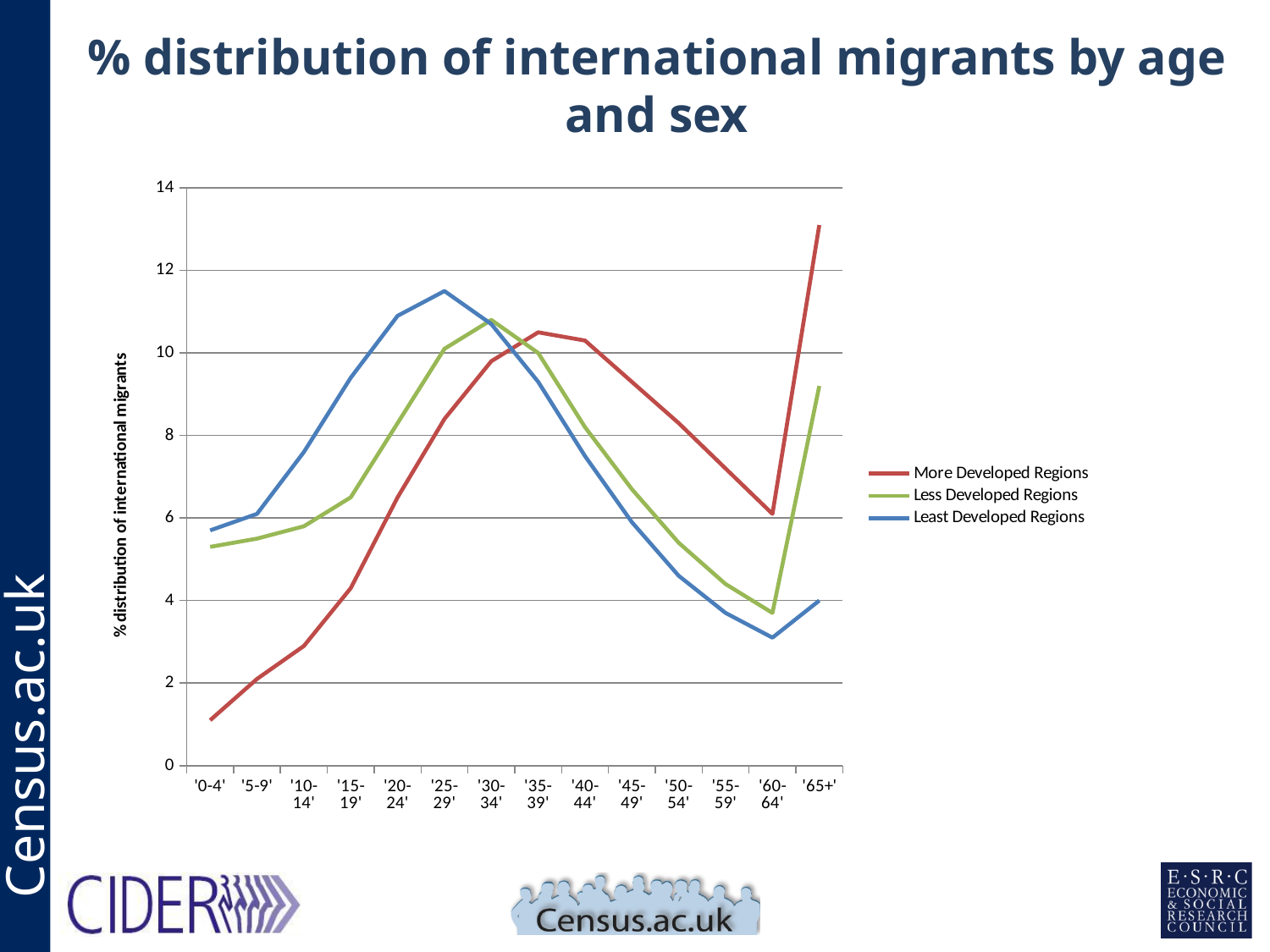
What colour is the line for Least Developed Regions? Blue At '0-4', which is larger: More Developed Regions or Least Developed Regions? Least Developed Regions For More Developed Regions, which age group has the highest value? '65+' For Least Developed Regions, which age group has the lowest value? '60-64' What kind of chart is shown on the slide? Line chart Does the More Developed Regions line rise or fall from '0-4' to '35-39'? rise How many age groups are shown along the x axis? 14 For More Developed Regions, which age group has the lowest value? '0-4' For Least Developed Regions, which age group has the highest value? '25-29' Is the value for More Developed Regions at '60-64' greater or less than 8? less Is the value for More Developed Regions at '65+' greater or less than 12? greater How many series does the legend list? 3